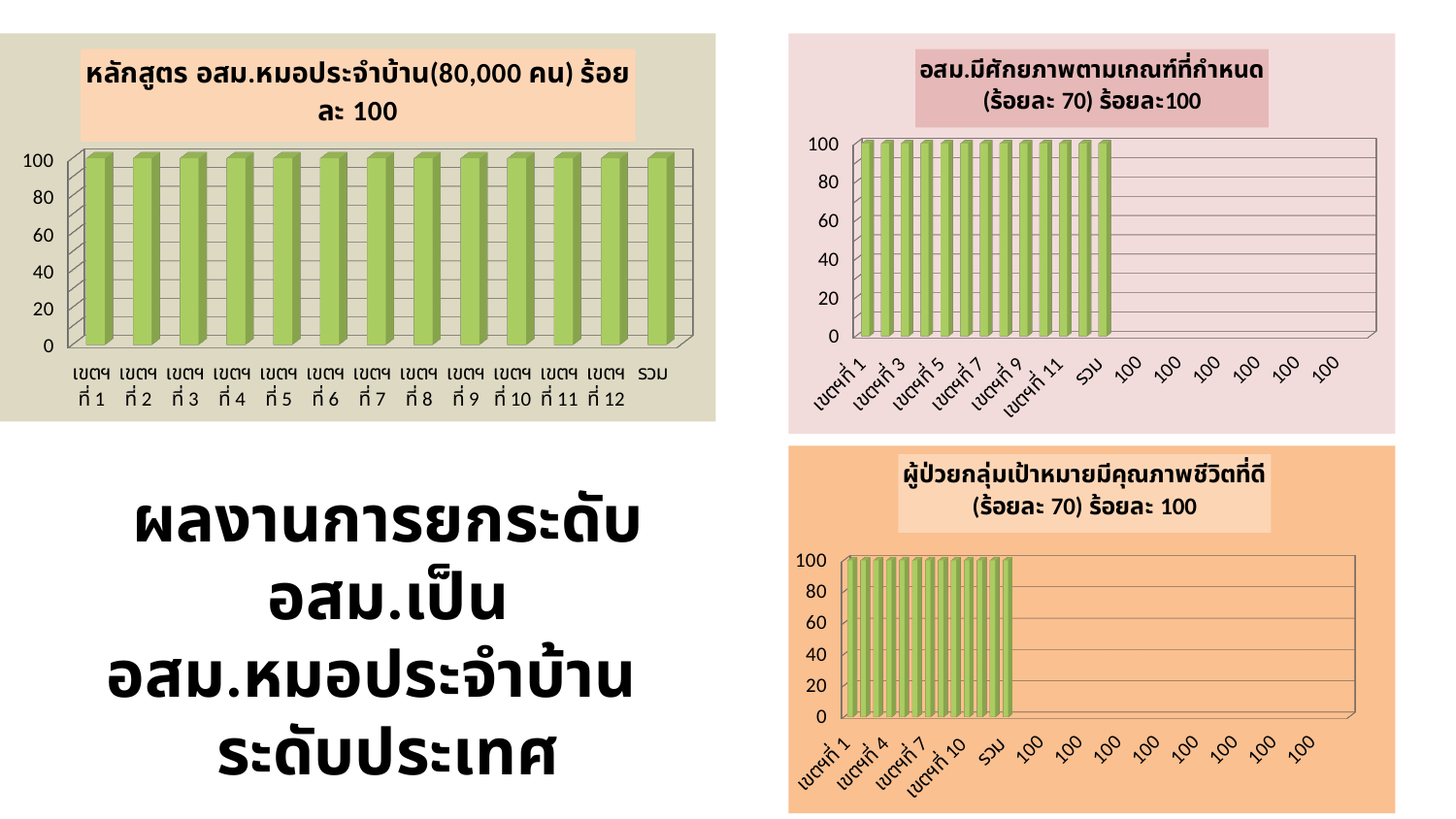
How many charts are shown on the slide? 3 In the top-left chart 'หลักสูตร อสม.หมอประจำบ้าน(80,000 คน) ร้อยละ 100', what is the value for เขตฯ ที่ 5? 100 In the top-right chart 'อสม.มีศักยภาพตามเกณฑ์ที่กำหนด (ร้อยละ 70) ร้อยละ100', what is the difference between the values for เขตฯที่ 1 and รวม? 0 In the top-right chart 'อสม.มีศักยภาพตามเกณฑ์ที่กำหนด (ร้อยละ 70) ร้อยละ100', is the value for เขตฯที่ 7 greater or less than 80? greater In the bottom-right chart 'ผู้ป่วยกลุ่มเป้าหมายมีคุณภาพชีวิตที่ดี (ร้อยละ 70) ร้อยละ 100', what is the value for รวม? 100 What kind of chart is the top-left chart titled 'หลักสูตร อสม.หมอประจำบ้าน(80,000 คน) ร้อยละ 100'? bar chart What kind of chart is the bottom-right chart titled 'ผู้ป่วยกลุ่มเป้าหมายมีคุณภาพชีวิตที่ดี (ร้อยละ 70) ร้อยละ 100'? bar chart In the top-right chart 'อสม.มีศักยภาพตามเกณฑ์ที่กำหนด (ร้อยละ 70) ร้อยละ100', what is the value for เขตฯที่ 3? 100 In the top-left chart 'หลักสูตร อสม.หมอประจำบ้าน(80,000 คน) ร้อยละ 100', is the value for เขตฯ ที่ 8 greater or less than 60? greater In the top-left chart 'หลักสูตร อสม.หมอประจำบ้าน(80,000 คน) ร้อยละ 100', how many categories are shown on the x axis? 13 In the top-left chart 'หลักสูตร อสม.หมอประจำบ้าน(80,000 คน) ร้อยละ 100', do the values rise, fall, or stay flat from เขตฯ ที่ 1 to เขตฯ ที่ 12? stay flat In the top-left chart 'หลักสูตร อสม.หมอประจำบ้าน(80,000 คน) ร้อยละ 100', what is the value for รวม? 100